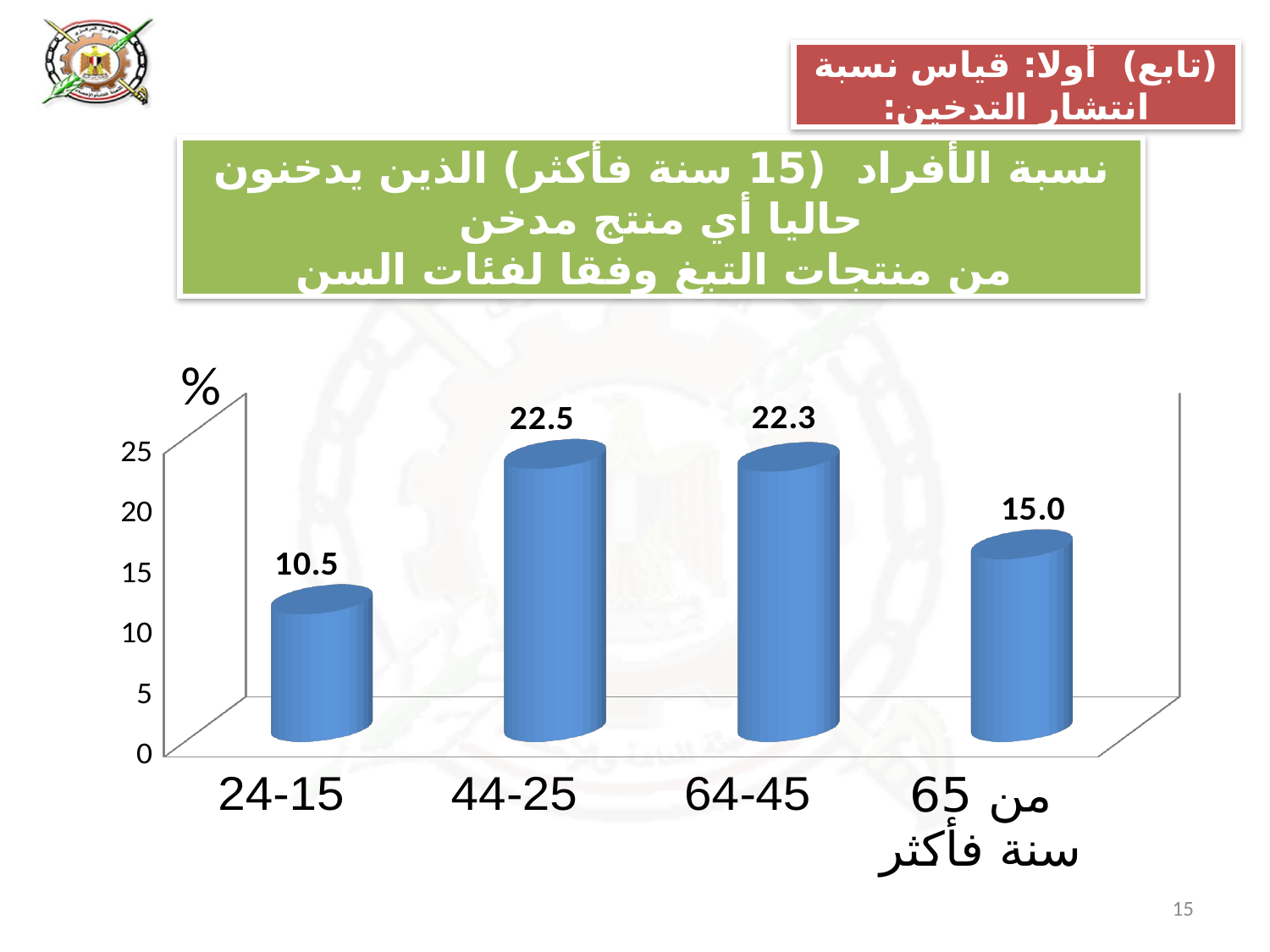
What unit is shown at the top of the vertical axis? % What is the value for the 45-64 age group? 22.3 What is the value for the 15-24 age group? 10.5 Which is larger, the value for the 65 and over age group or the 15-24 age group? 65 and over What kind of chart is shown on the slide? Bar chart Which age group has the highest value? 25-44 Which age group has the lowest value? 15-24 What is the difference between the values for the 45-64 and 65 and over age groups? 7.3 What is the value for the 65 and over age group (من 65 سنة فأكثر)? 15.0 What is the difference between the values for the 25-44 and 15-24 age groups? 12.0 What is the value for the 25-44 age group? 22.5 How many age groups are shown on the chart? 4